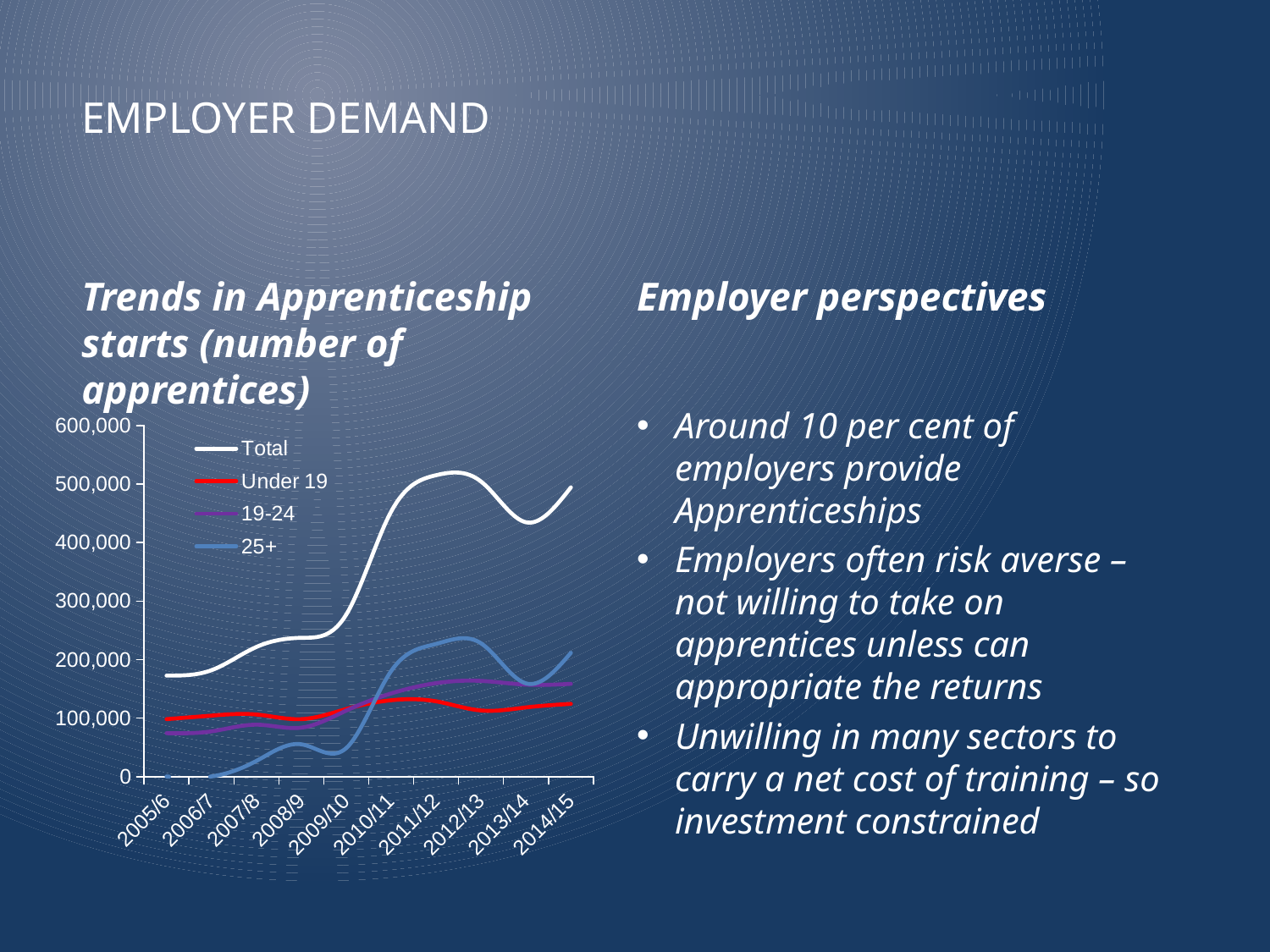
Which series in the chart is drawn in red? Under 19 In 2014/15, which is larger: the 25+ value or the 19-24 value? 25+ What is the title of the chart? Trends in Apprenticeship starts (number of apprentices) How many years are plotted along the x axis of the chart? 10 Is the 19-24 value for 2005/6 greater or less than 100,000? less Is the Total value for 2013/14 greater or less than 400,000? greater Is the Total value for 2005/6 greater or less than 200,000? less What kind of chart is shown on the slide? line chart Which series has the lowest value in 2005/6? 25+ How many series does the chart legend list? 4 Does the Total series rise or fall between 2005/6 and 2011/12? rise